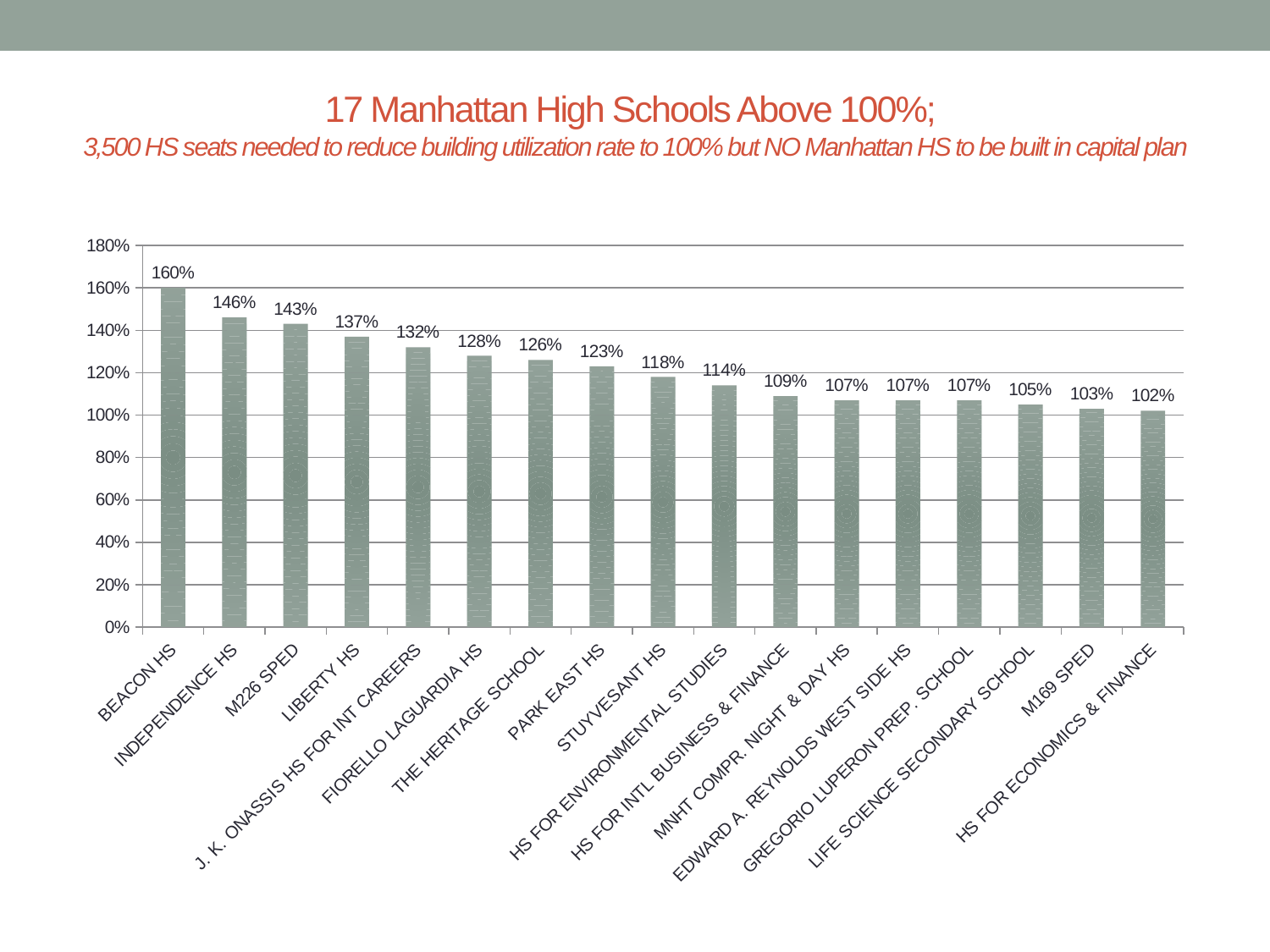
What kind of chart is shown on the slide? Bar chart What is the value shown for FIORELLO LAGUARDIA HS? 128% What is the value shown for M169 SPED? 103% Which school has the lowest value on the chart? HS FOR ECONOMICS & FINANCE How many schools are shown on the chart? 17 Which school has the highest value on the chart? BEACON HS Which has a larger value, LIBERTY HS or PARK EAST HS? LIBERTY HS What is the difference between the values for BEACON HS and INDEPENDENCE HS? 14% Do the values rise or fall from left to right along the x axis? Fall What is the value shown for STUYVESANT HS? 118% What is the difference between the values for THE HERITAGE SCHOOL and HS FOR ENVIRONMENTAL STUDIES? 12% What is the utilization rate shown for BEACON HS? 160%